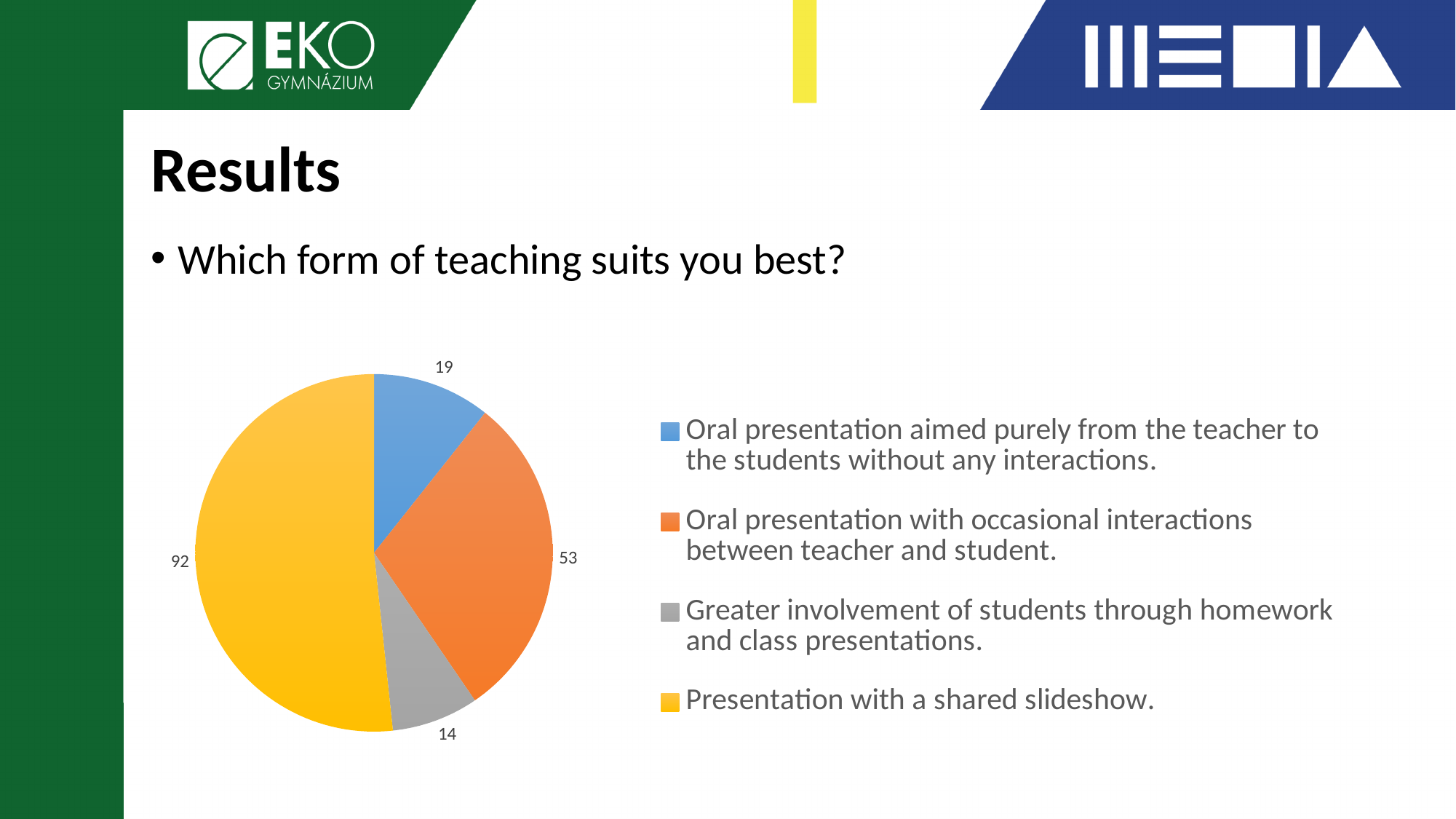
What is the value for "Greater involvement of students through homework and class presentations."? 14 Which teaching form has the smallest slice of the pie? Greater involvement of students through homework and class presentations. What is the total of all the values shown in the pie chart? 178 What type of chart is shown on the slide? pie chart What is the difference between the value for "Presentation with a shared slideshow." and the value for "Oral presentation with occasional interactions between teacher and student."? 39 What colour is the slice for "Presentation with a shared slideshow."? yellow What is the value for "Presentation with a shared slideshow."? 92 Which teaching form has the largest slice of the pie? Presentation with a shared slideshow. How many slices does the pie chart have? 4 Which is larger: the value for "Oral presentation aimed purely from the teacher to the students without any interactions." or the value for "Greater involvement of students through homework and class presentations."? Oral presentation aimed purely from the teacher to the students without any interactions. What is the value for "Oral presentation with occasional interactions between teacher and student."? 53 What is the value for "Oral presentation aimed purely from the teacher to the students without any interactions."? 19